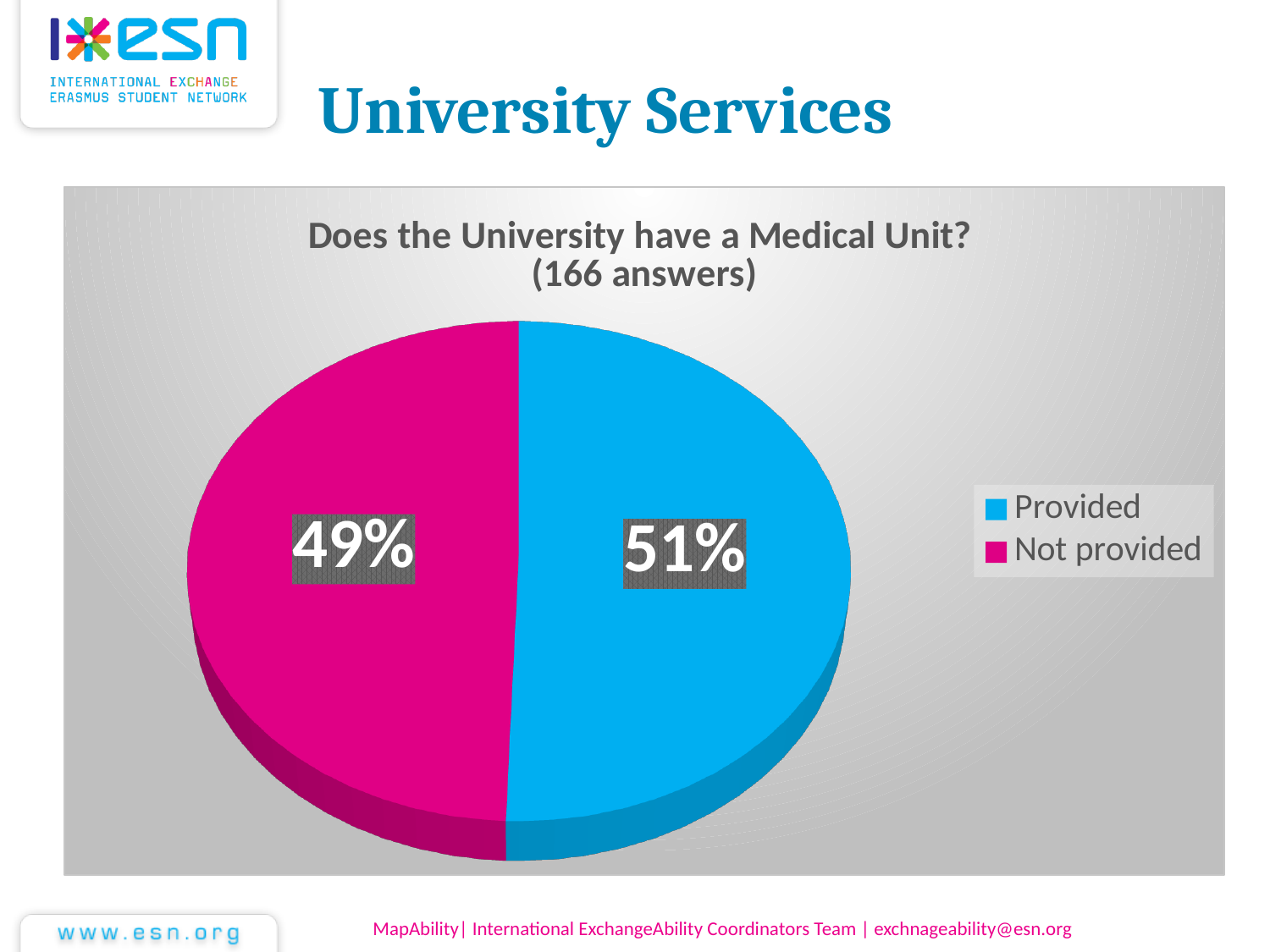
How many entries does the legend list? 2 What is the title of the pie chart? Does the University have a Medical Unit? (166 answers) What kind of chart is shown on the slide? pie chart What share of the pie is labelled "Not provided"? 49% Which slice is larger, "Provided" or "Not provided"? Provided What share of the pie is labelled "Provided"? 51% How many slices does the pie chart have? 2 Which category has the smallest slice of the pie? Not provided Which category has the largest slice of the pie? Provided How many answers does the chart title say the data is based on? 166 What is the difference in percentage points between the "Provided" and "Not provided" slices? 2 What colour is the "Not provided" slice? magenta